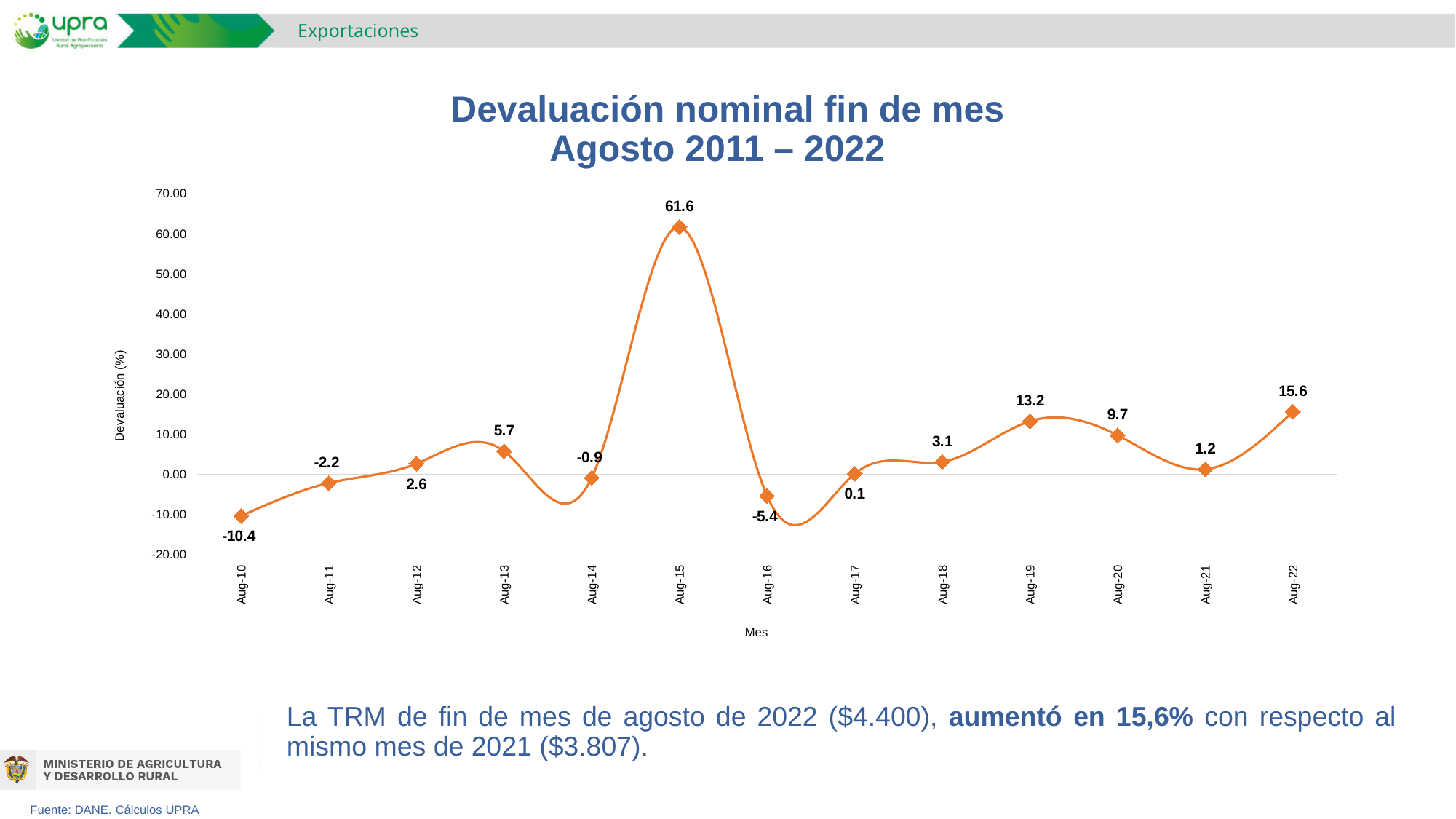
What is the devaluation value for Aug-10? -10.4 What is the devaluation value for Aug-22? 15.6 What is the label of the y axis? Devaluación (%) What is the devaluation value for Aug-15? 61.6 How many data points are plotted on the chart? 13 Which month has the lowest devaluation value? Aug-10 Does the value rise or fall from Aug-21 to Aug-22? Rise Which month has the highest devaluation value? Aug-15 Which is larger, the value for Aug-19 or the value for Aug-20? Aug-19 What is the devaluation value for Aug-19? 13.2 What type of chart is shown on the slide? Line chart What is the difference between the values for Aug-22 and Aug-21? 14.4